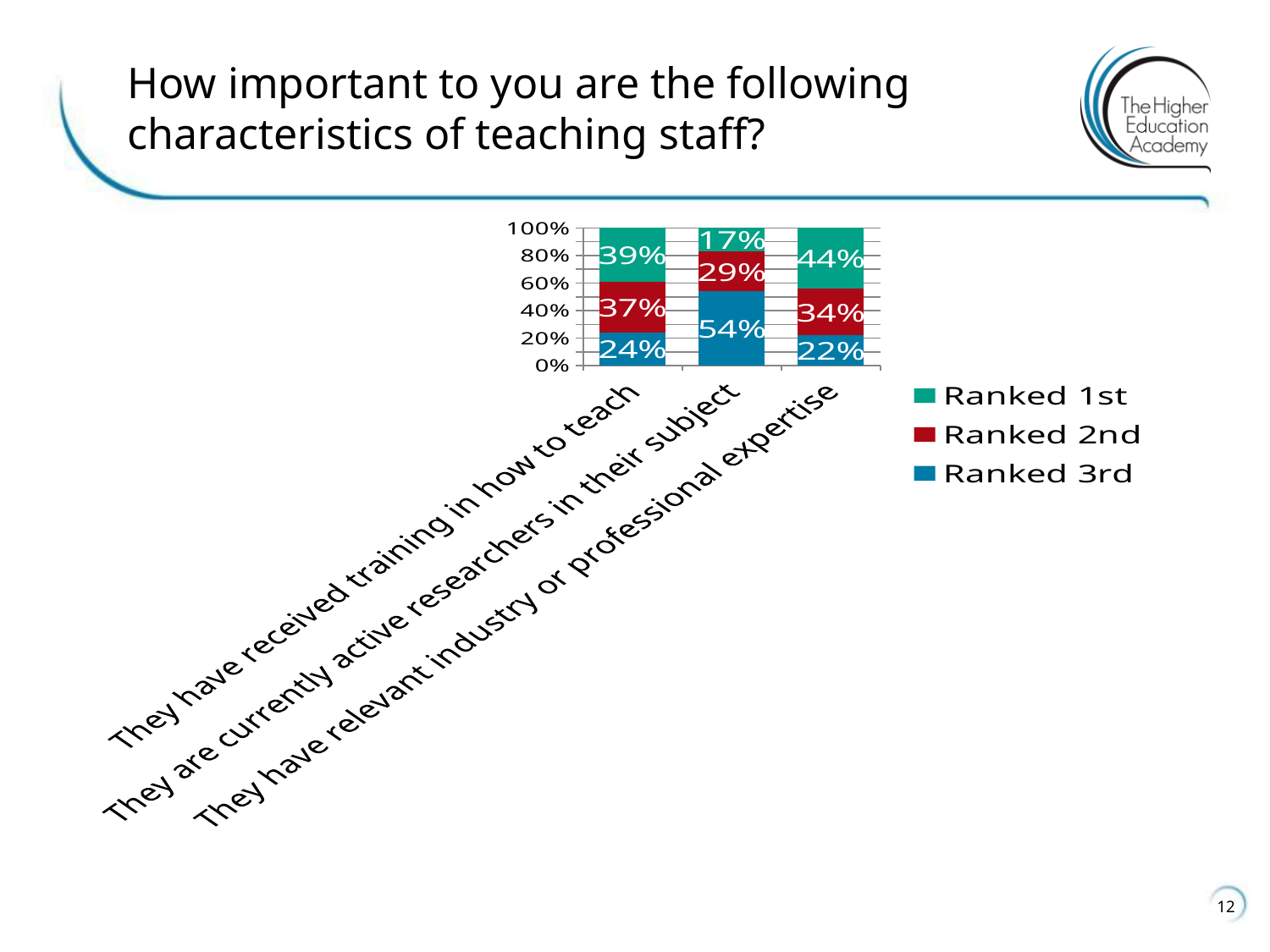
How many characteristics of teaching staff are shown on the x axis? 3 Which characteristic has the highest share of 'Ranked 1st' responses? They have relevant industry or professional expertise Which characteristic has the lowest share of 'Ranked 1st' responses? They are currently active researchers in their subject How many series does the legend list? 3 What percentage of respondents ranked 'They have received training in how to teach' 1st? 39% What kind of chart is shown on the slide? Stacked bar chart What percentage of respondents ranked 'They are currently active researchers in their subject' 3rd? 54% What percentage of respondents ranked 'They have relevant industry or professional expertise' 2nd? 34% Which is larger: the 'Ranked 2nd' share for 'They have received training in how to teach' or for 'They have relevant industry or professional expertise'? They have received training in how to teach What is the total of the stacked bar for 'They have relevant industry or professional expertise'? 100% Which colour represents 'Ranked 3rd' in the legend? Blue What is the difference between the 'Ranked 3rd' share for 'They are currently active researchers in their subject' and for 'They have received training in how to teach'? 30%